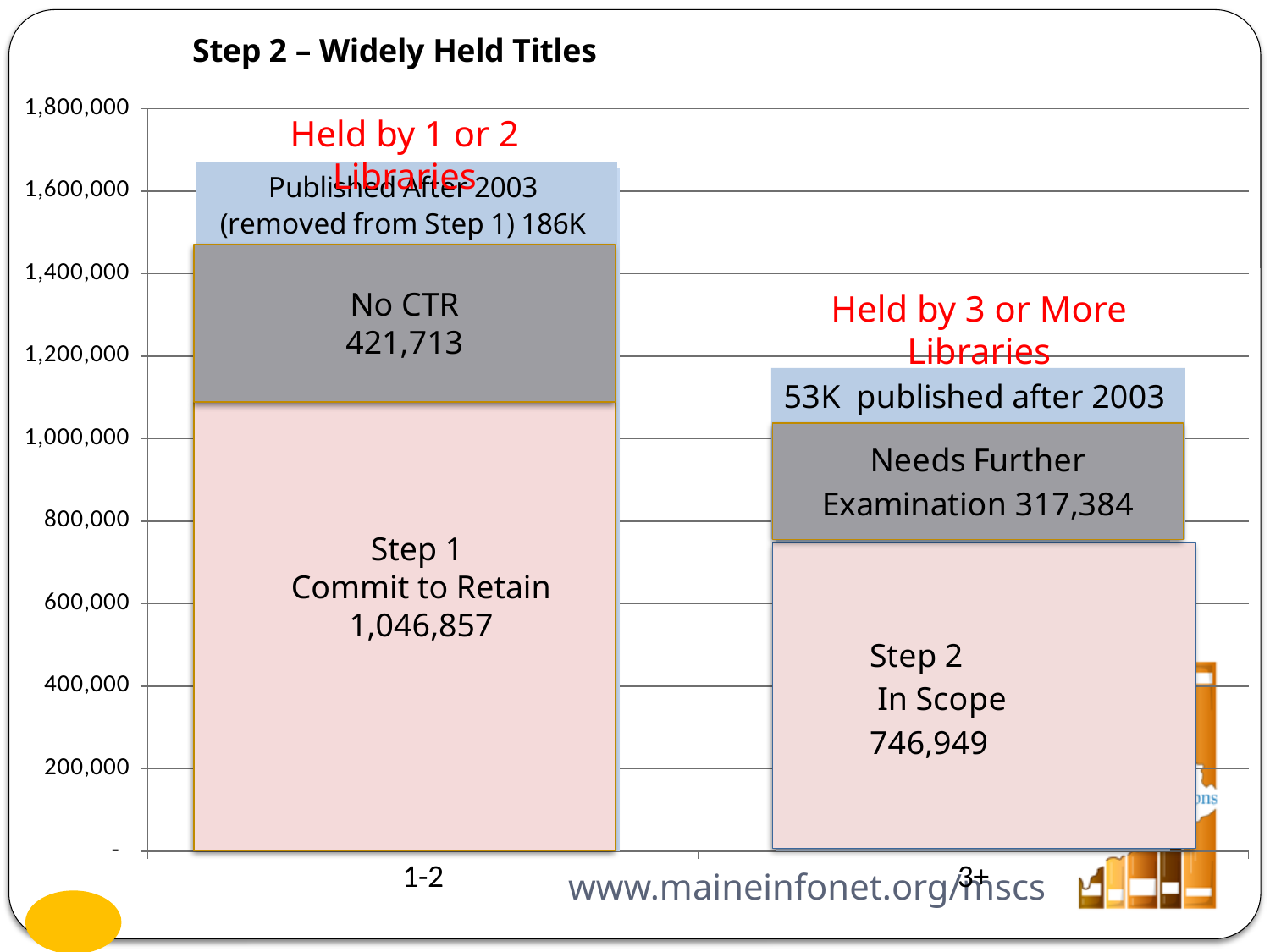
What is the difference between the Step 1 Commit to Retain value and the Step 2 In Scope value? 299,908 What is the value of the Step 1 Commit to Retain segment in the 1-2 bar? 1,046,857 How many titles published after 2003 are shown in the 3+ bar? 53K What is the value of the Needs Further Examination segment in the 3+ bar? 317,384 Which is larger: the Step 1 Commit to Retain segment or the Step 2 In Scope segment? Step 1 Commit to Retain How many categories are shown on the x axis? 2 What is the value of the No CTR segment in the 1-2 bar? 421,713 Is the total height of the 3+ bar greater or less than 1,000,000? greater What value is shown for the Published After 2003 (removed from Step 1) segment in the 1-2 bar? 186K What is the difference between the No CTR value and the Needs Further Examination value? 104,329 What kind of chart is shown on the slide? Bar chart What is the value of the Step 2 In Scope segment in the 3+ bar? 746,949